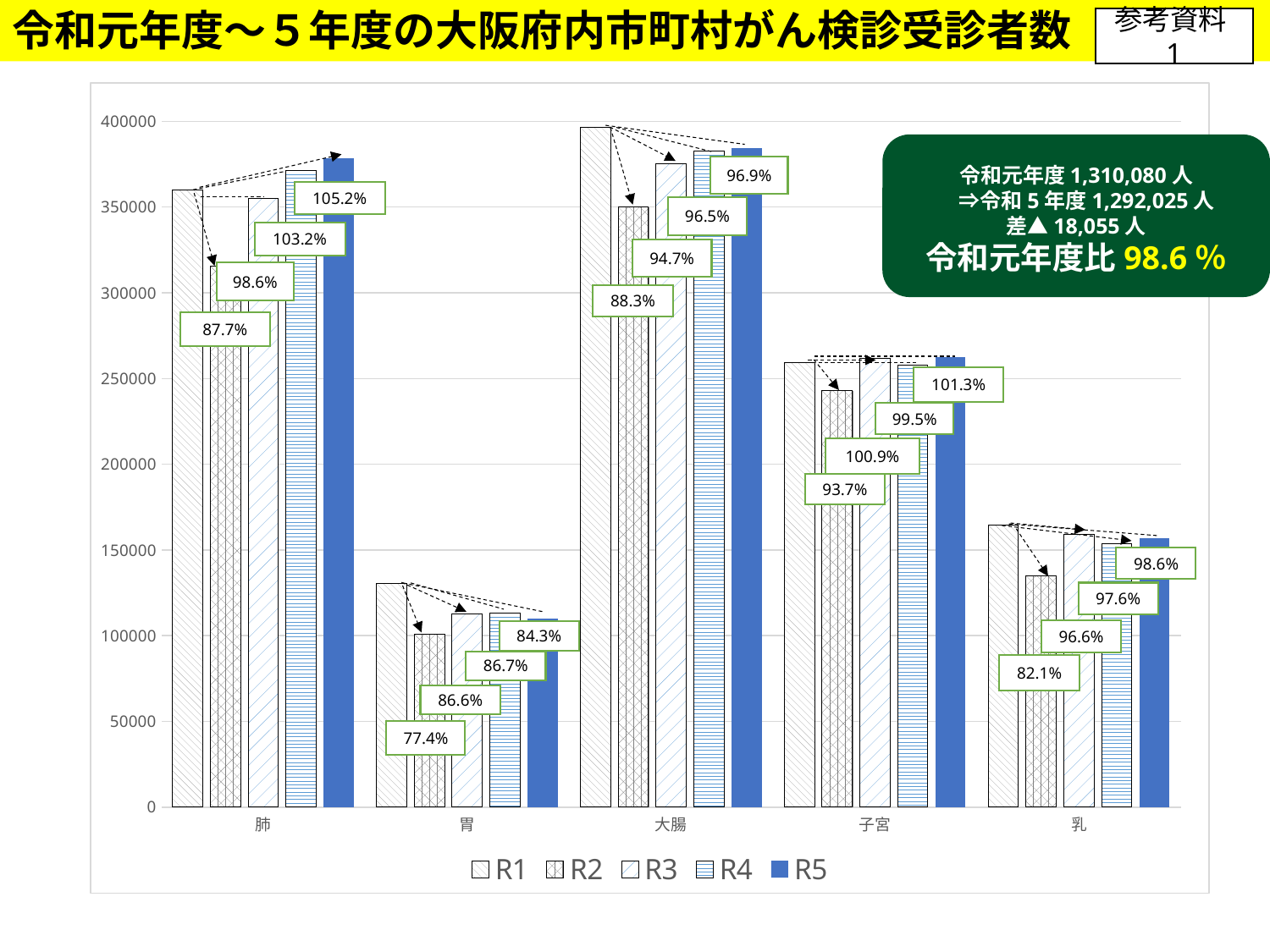
What percentage label is shown for the R5 bar in the 肺 category? 105.2% What percentage label is shown for the R2 bar in the 胃 category? 77.4% Which category has the shortest bars in the chart? 胃 Is the R1 value for 乳 greater or less than 150000? greater Is the R1 value for 胃 greater or less than 100000? greater What percentage label is shown for the R4 bar in the 大腸 category? 96.5% What percentage label is shown for the R3 bar in the 子宮 category? 100.9% Which is larger in the 肺 category, the R1 bar or the R5 bar? R5 How many categories are shown on the x axis of the chart? 5 What kind of chart is shown on the slide? bar chart How many series does the chart legend list? 5 Which category has the tallest bars in the chart? 大腸